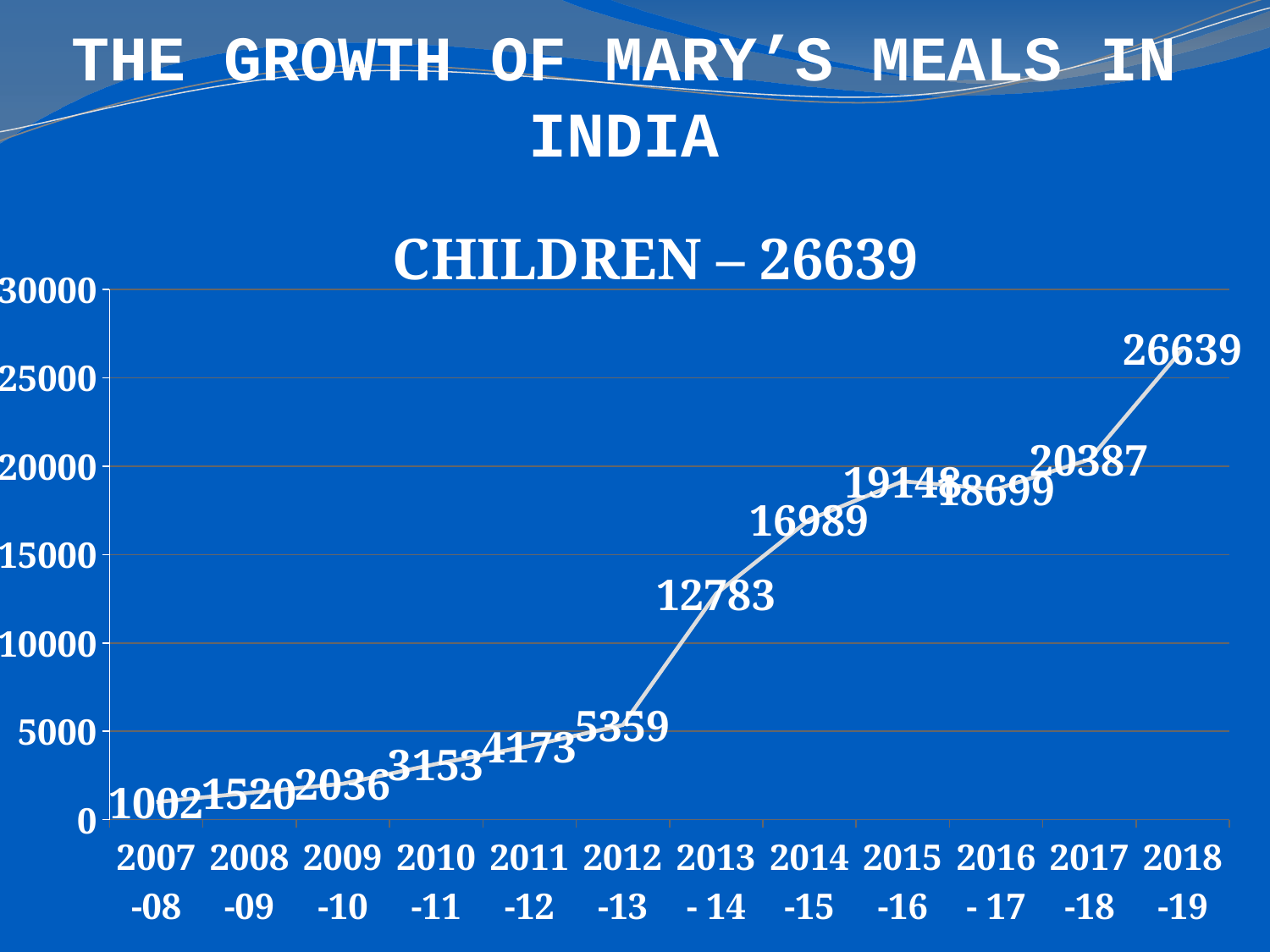
Which year has the lowest value? 2007-08 Which year has the highest value? 2018-19 What is the value for 2012-13? 5359 Is the value for 2014-15 greater or less than 15000? greater Which is larger, the value for 2017-18 or the value for 2016-17? 2017-18 What is the value for 2007-08? 1002 What is the value for 2013-14? 12783 What is the value for 2018-19? 26639 How many data points are plotted on the chart? 12 What type of chart is shown on the slide? line chart What is the difference between the values for 2013-14 and 2012-13? 7424 What is the title of the chart? CHILDREN – 26639